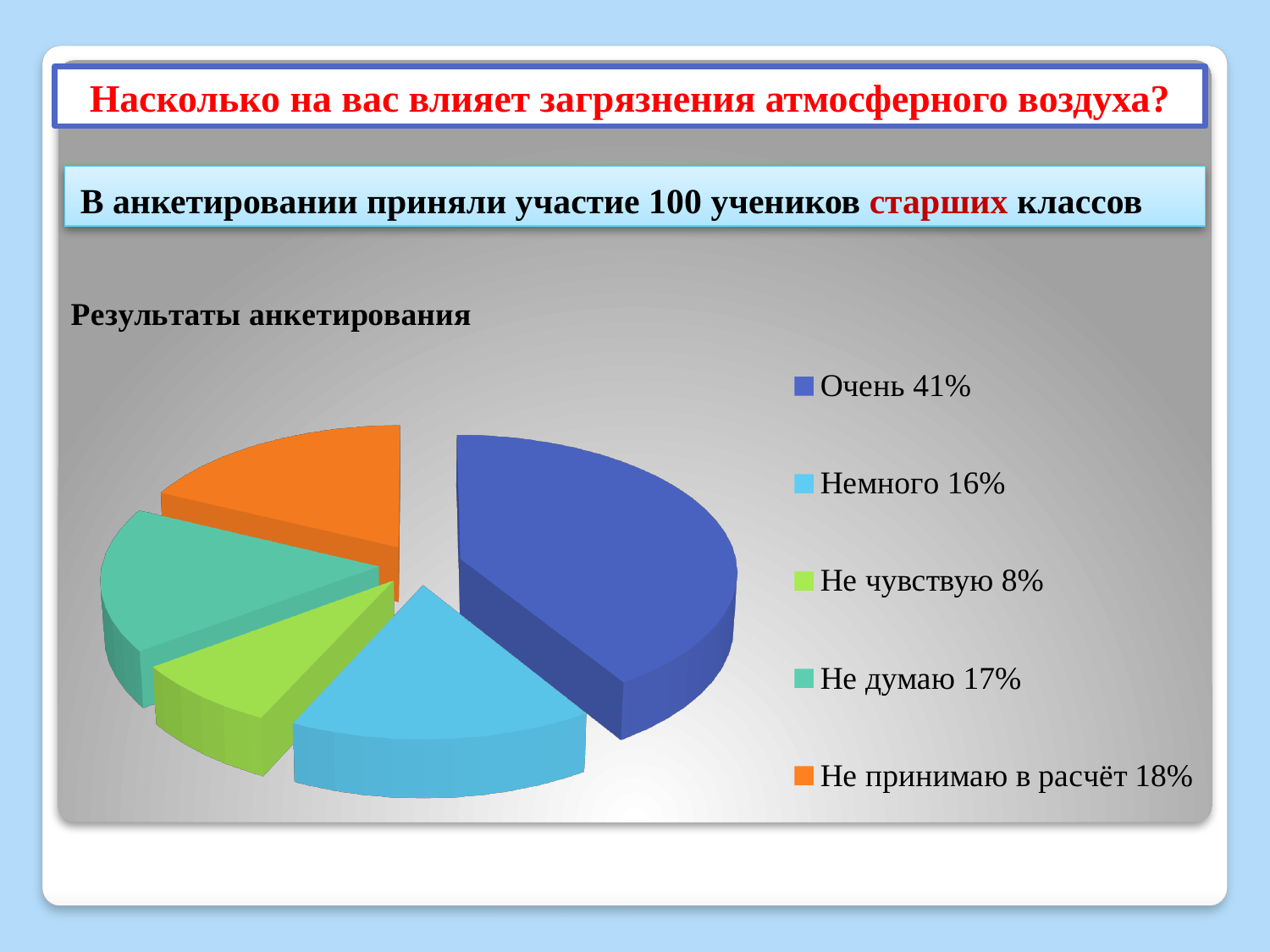
What is the title of the chart? Результаты анкетирования How many categories does the pie chart have? 5 Which is larger, the value for "Не думаю" or the value for "Немного"? Не думаю Which category has the largest share of the pie chart? Очень What is the difference between the values for "Очень" and "Не думаю"? 24% What is the value for "Очень" in the pie chart? 41% What kind of chart is shown on the slide? pie chart Which category has the smallest share of the pie chart? Не чувствую What is the value for "Не принимаю в расчёт" in the pie chart? 18% What is the value for "Не чувствую" in the pie chart? 8% What is the value for "Немного" in the pie chart? 16% What colour is the slice for "Не принимаю в расчёт"? orange